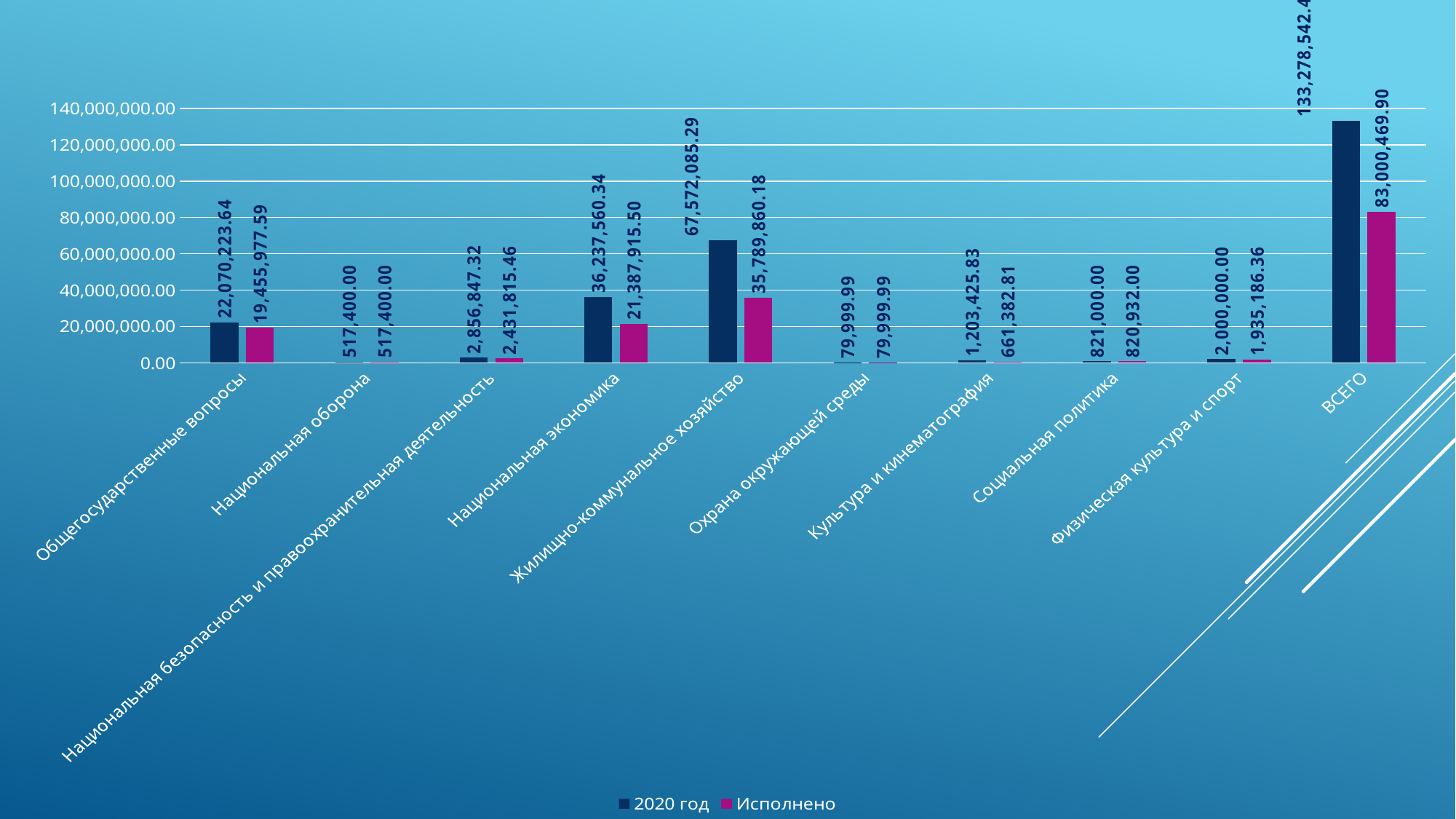
What is the Исполнено value for Национальная экономика? 21,387,915.50 Is the Исполнено value for ВСЕГО greater or less than 80,000,000.00? greater How many categories are shown on the x axis? 10 What type of chart is shown on the slide? bar chart What is the Исполнено value for ВСЕГО? 83,000,469.90 Which category has the lowest 2020 год value? Охрана окружающей среды What is the 2020 год value for Жилищно-коммунальное хозяйство? 67,572,085.29 Which category has the highest Исполнено value? ВСЕГО What is the difference between the 2020 год and Исполнено values for Жилищно-коммунальное хозяйство? 31,782,225.11 Which is larger for Общегосударственные вопросы: the 2020 год value or the Исполнено value? 2020 год What is the 2020 год value for Культура и кинематография? 1,203,425.83 How many series does the legend list? 2